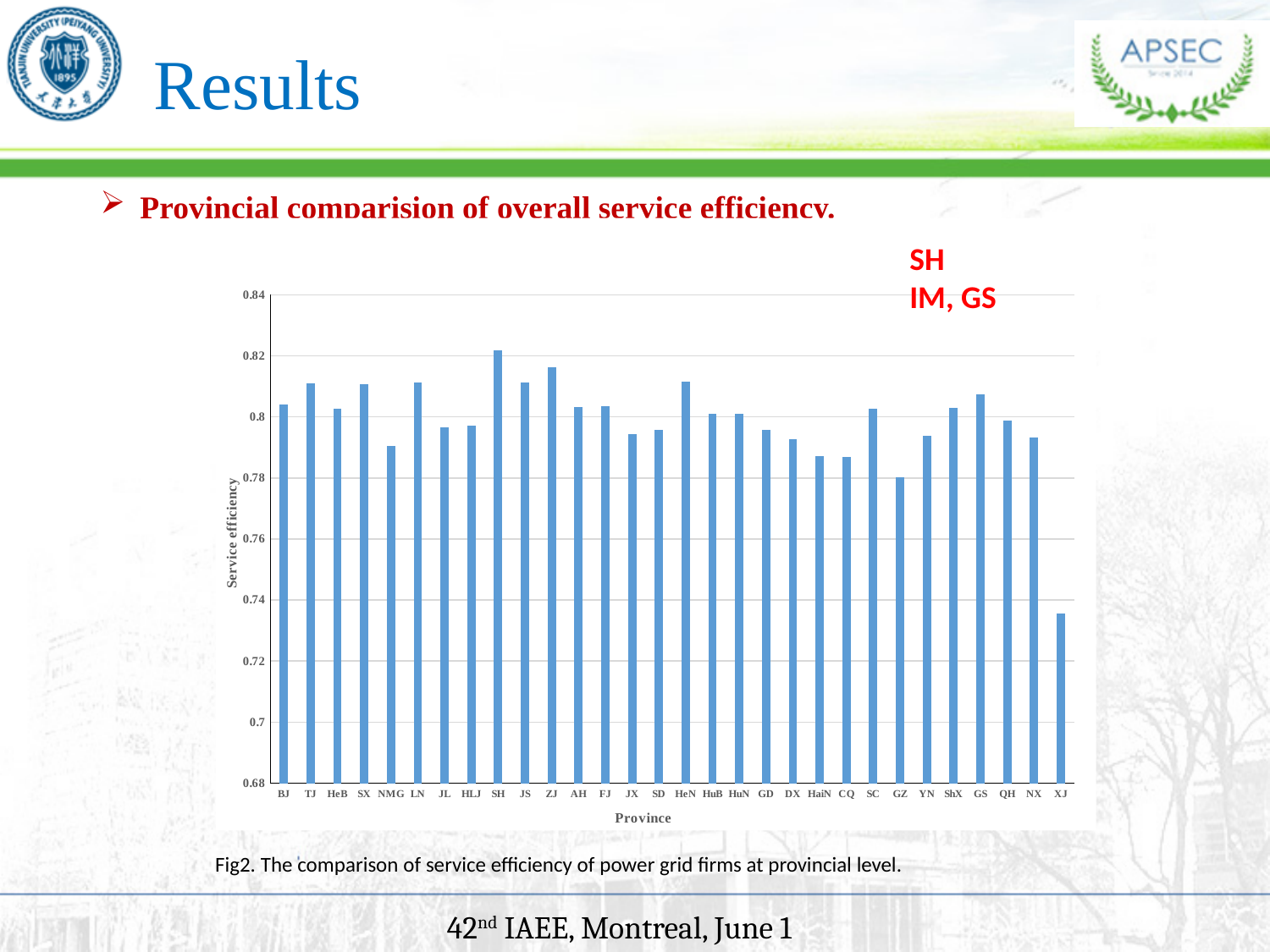
Which has the larger service efficiency, TJ or NMG? TJ Which province has the highest service efficiency in the chart? SH Which province has the lowest service efficiency in the chart? XJ Is the service efficiency value for NMG greater or less than 0.8? less What kind of chart is shown on the slide? bar chart Is the service efficiency value for SH greater or less than 0.82? greater Is the service efficiency value for XJ greater or less than 0.74? less What is the label of the horizontal axis of the chart? Province What is the label of the vertical axis of the chart? Service efficiency Which has the larger service efficiency, SH or XJ? SH How many provinces are plotted on the x axis of the chart? 30